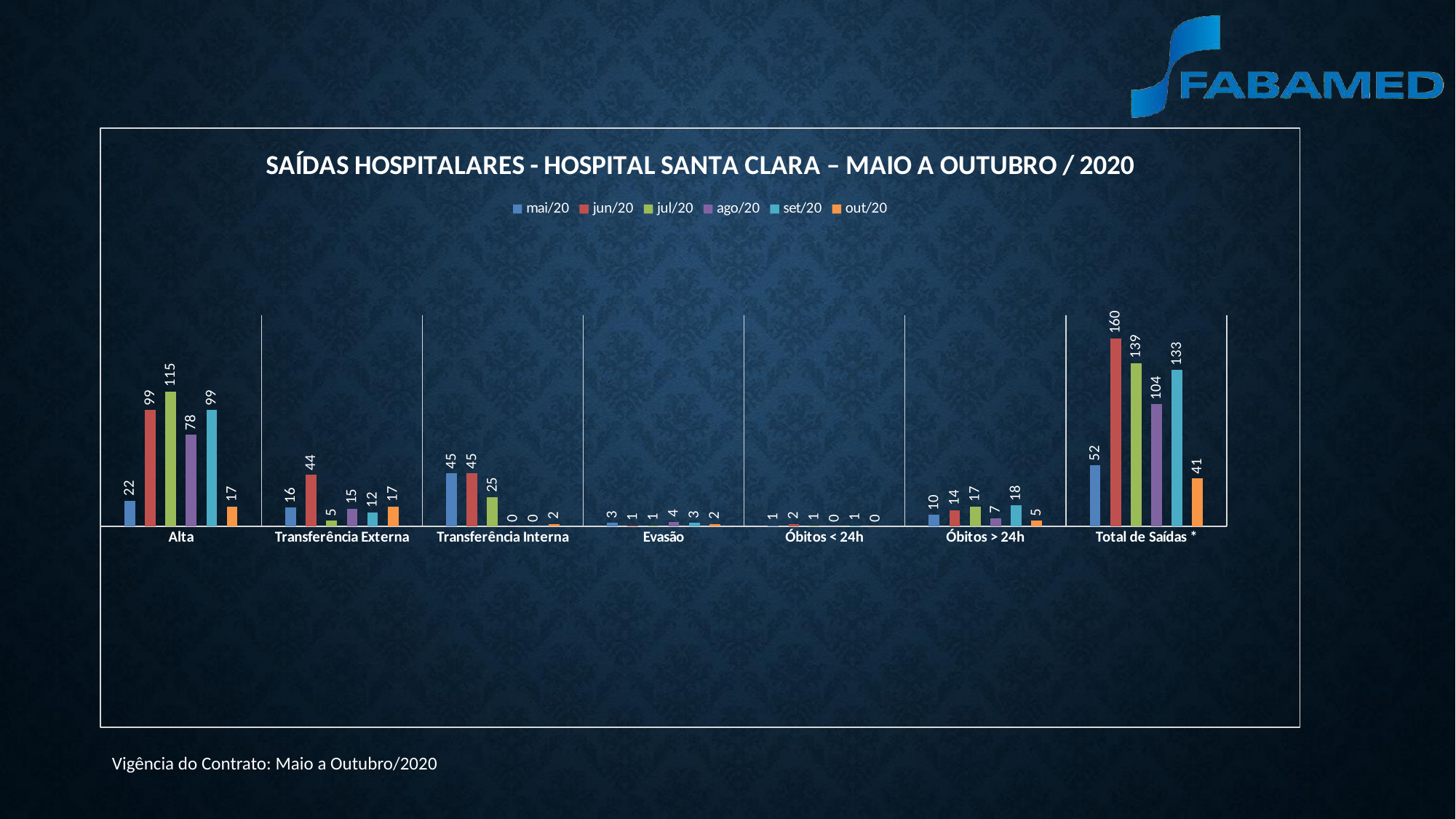
Which month has the highest value in the Total de Saídas * category? jun/20 How many series does the legend list? 6 What is the value for set/20 in the Transferência Interna category? 0 What is the value for jun/20 in the Total de Saídas * category? 160 What is the value for jul/20 in the Alta category? 115 What is the difference between the jun/20 and mai/20 values in the Total de Saídas * category? 108 What is the title of the chart? SAÍDAS HOSPITALARES - HOSPITAL SANTA CLARA – MAIO A OUTUBRO / 2020 In the Óbitos > 24h category, which is larger: the set/20 value or the jul/20 value? set/20 How many categories are shown on the x axis? 7 Which month has the lowest value in the Alta category? out/20 What kind of chart is shown on the slide? bar chart What is the value for ago/20 in the Transferência Externa category? 15